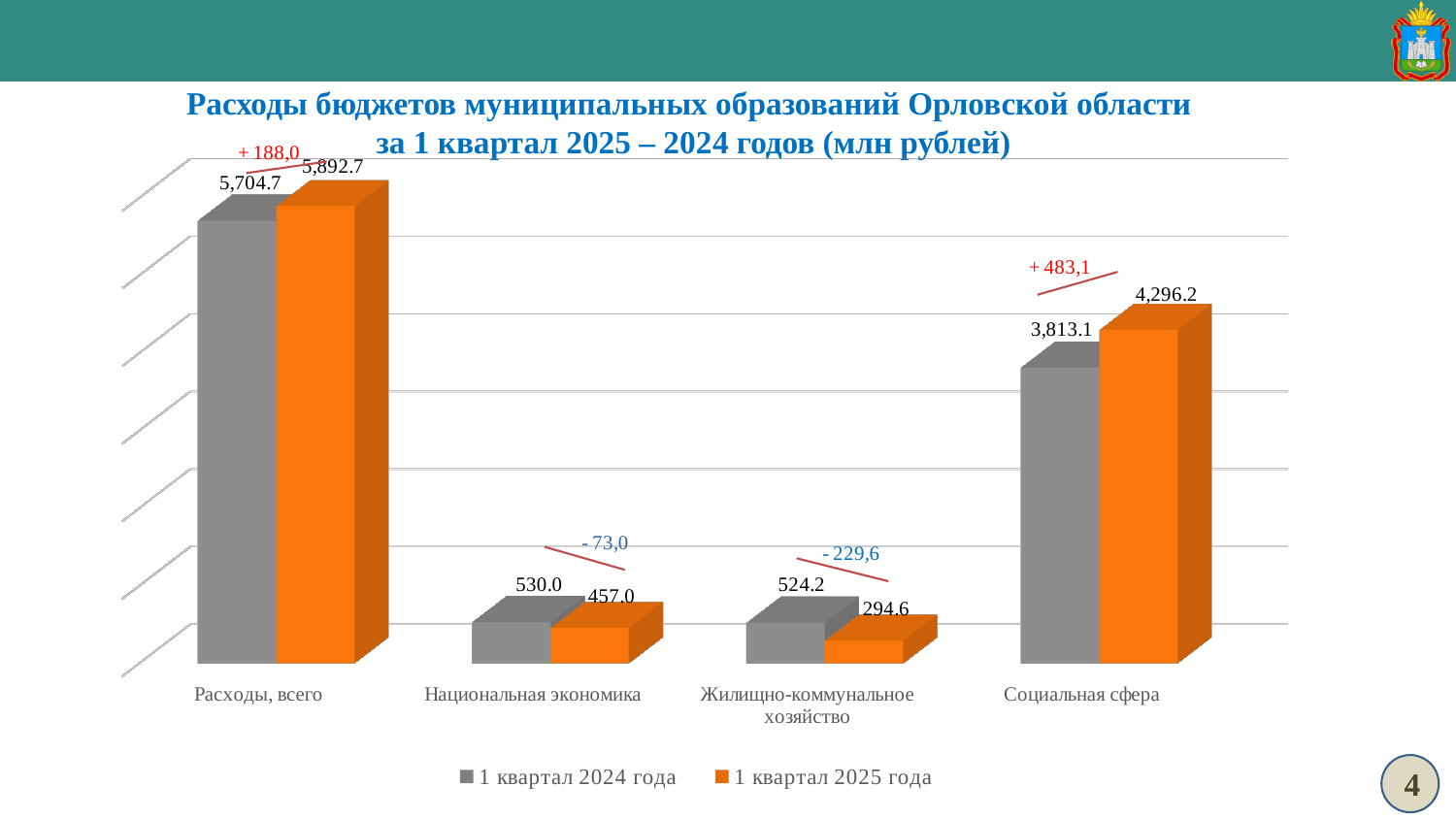
For Национальная экономика, which series has the larger value: 1 квартал 2024 года or 1 квартал 2025 года? 1 квартал 2024 года What kind of chart is shown on the slide? Bar chart Which category has the lowest value in the 1 квартал 2025 года series? Жилищно-коммунальное хозяйство What is the value for Национальная экономика in the 1 квартал 2024 года series? 530.0 What is the value for Расходы, всего in the 1 квартал 2025 года series? 5,892.7 What is the value for Социальная сфера in the 1 квартал 2024 года series? 3,813.1 What is the difference between the 1 квартал 2025 года and 1 квартал 2024 года values for Социальная сфера? 483.1 What is the difference between the 1 квартал 2024 года and 1 квартал 2025 года values for Жилищно-коммунальное хозяйство? 229.6 Which category has the highest value in the 1 квартал 2024 года series? Расходы, всего How many series does the legend list? 2 How many categories are shown on the x axis? 4 What is the value for Жилищно-коммунальное хозяйство in the 1 квартал 2025 года series? 294.6